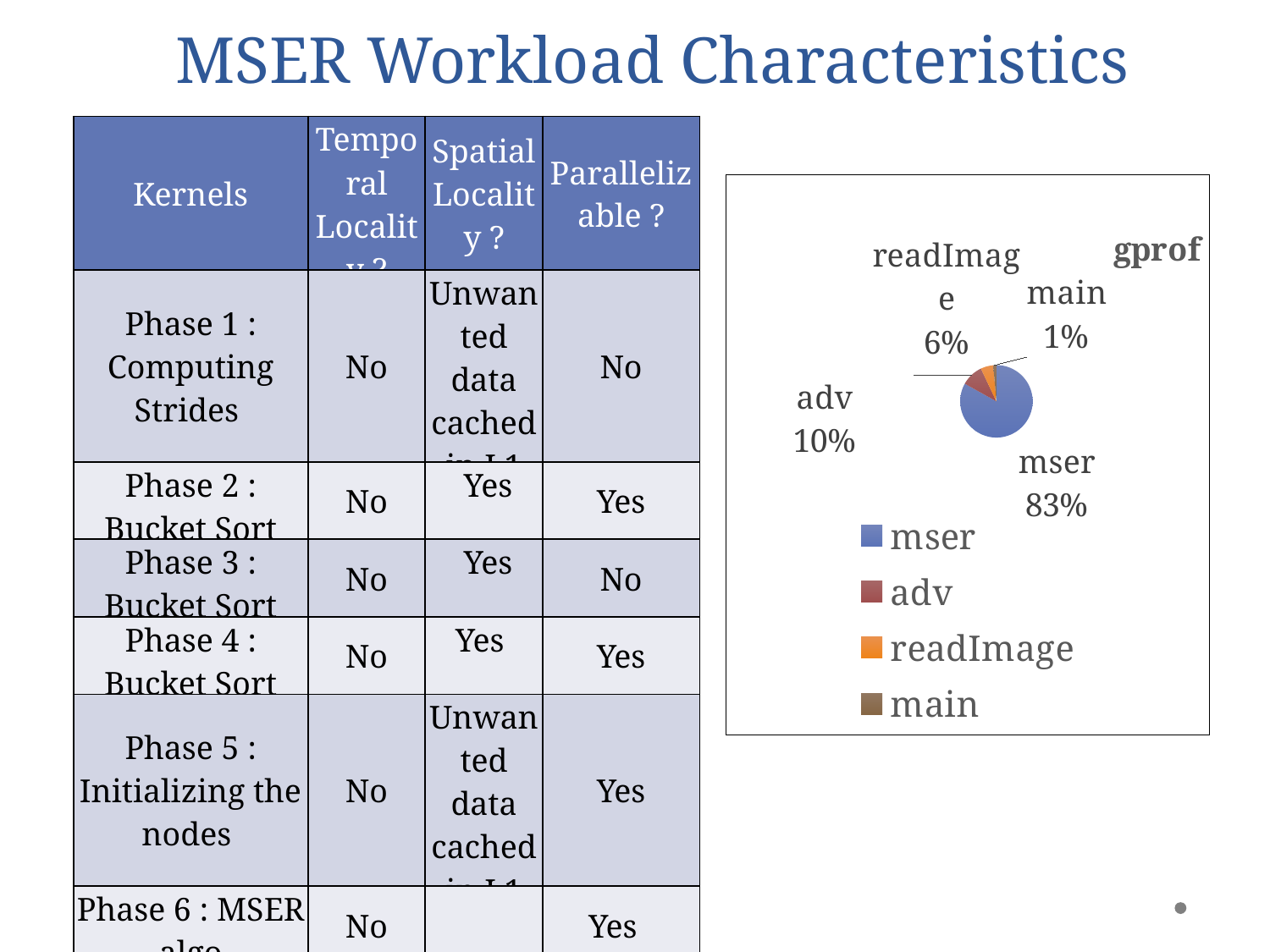
Which slice of the pie chart is the smallest? main What is the difference between the shares of adv and readImage? 4% Which has a larger share, adv or readImage? adv What share of the pie does adv have? 10% What share of the pie does mser have? 83% What is the title of the pie chart? gprof How many slices does the pie chart have? 4 What kind of chart is shown on the slide? pie chart How many entries does the legend of the pie chart list? 4 Which slice of the pie chart is the largest? mser What share of the pie does readImage have? 6%